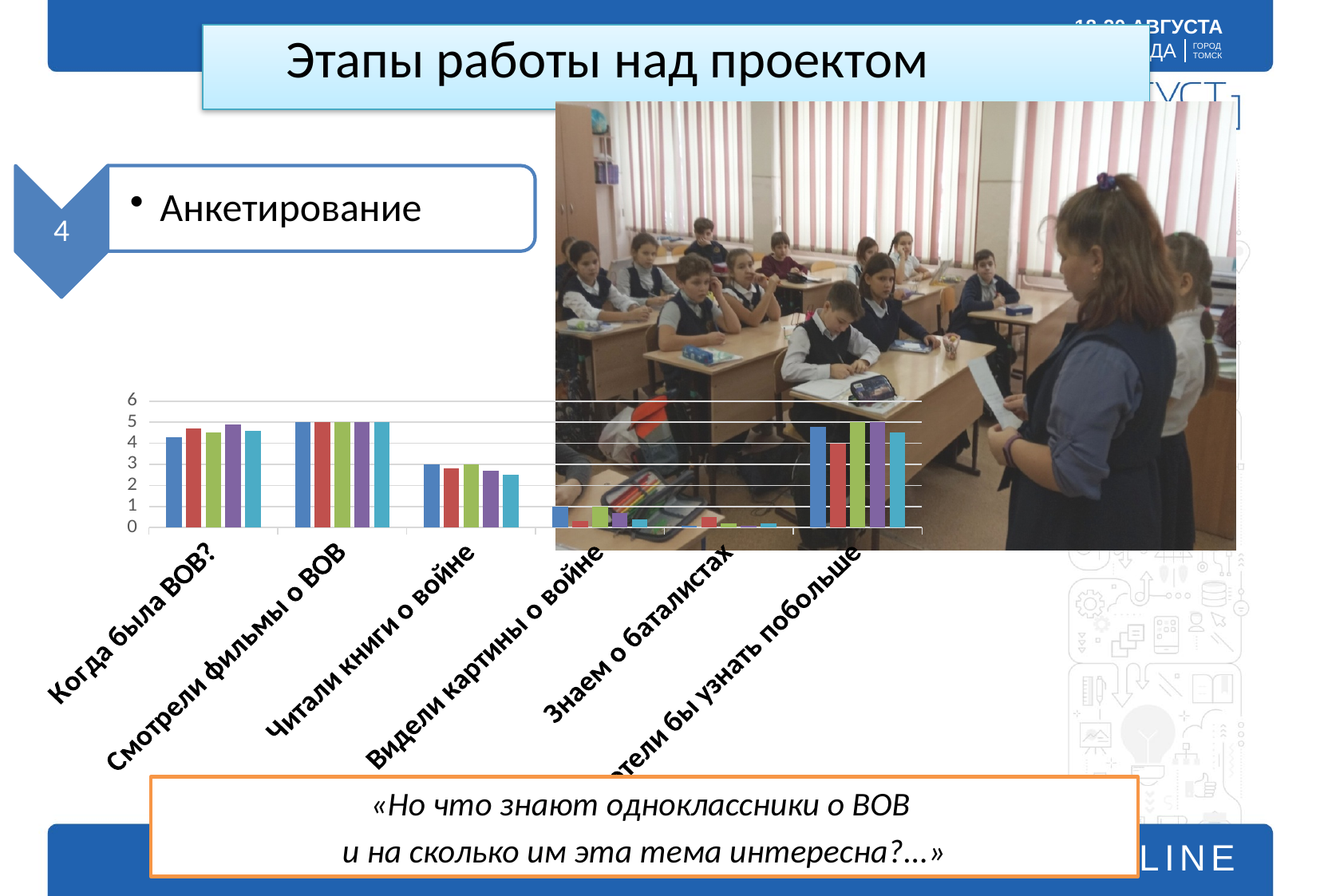
What kind of chart is shown on the slide? bar chart Which category has the lowest bars in the chart? Знаем о баталистах Is the value of the first (blue) bar for "Читали книги о войне" greater or less than 4? less How many categories are shown on the x axis of the chart? 6 Is the value of the first (blue) bar for "Когда была ВОВ?" greater or less than 4? greater What value do the bars for "Смотрели фильмы о ВОВ" reach on the y axis? 5 Are the bars for "Знаем о баталистах" greater or less than 1? less What is the maximum value shown on the y axis of the chart? 6 Which category has the highest bars in the chart? Смотрели фильмы о ВОВ Which category has higher bars: "Читали книги о войне" or "Смотрели фильмы о ВОВ"? Смотрели фильмы о ВОВ Which category has higher bars: "Видели картины о войне" or "Когда была ВОВ?"? Когда была ВОВ?